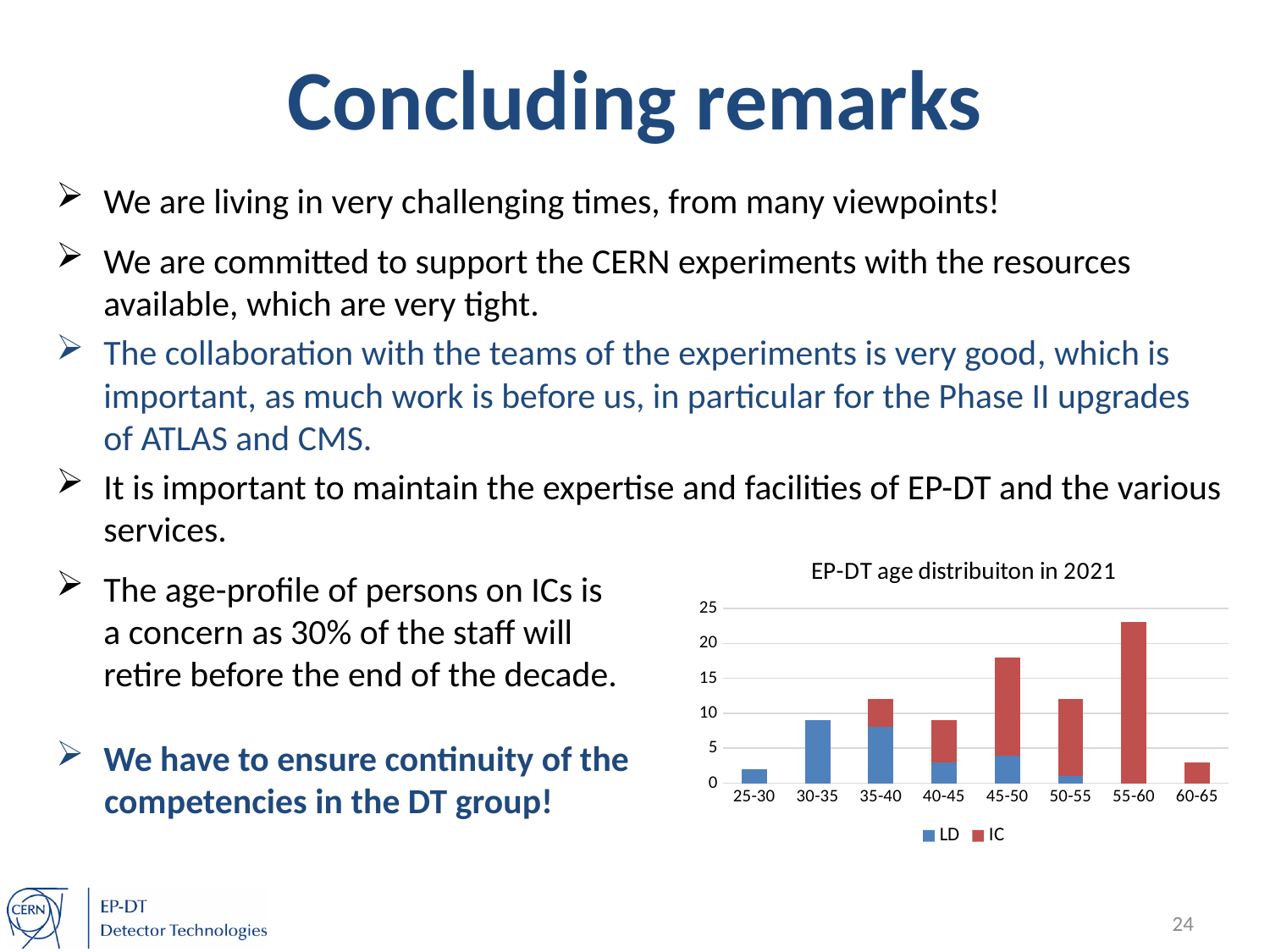
Is the total value for the 35-40 age category greater or less than 10? greater What type of chart is shown on the slide? stacked bar chart Is the total value for the 45-50 age category greater or less than 15? greater How many series does the chart legend list? 2 Which age category has the largest IC segment in the chart? 55-60 Is the total value for the 55-60 age category greater or less than 20? greater Which has the larger total bar, the 45-50 or the 40-45 age category? 45-50 Which age category has the highest total bar in the chart? 55-60 How many age categories are shown on the x axis of the chart? 8 What is the title of the chart on the slide? EP-DT age distribuiton in 2021 Which series is shown in red in the chart? IC